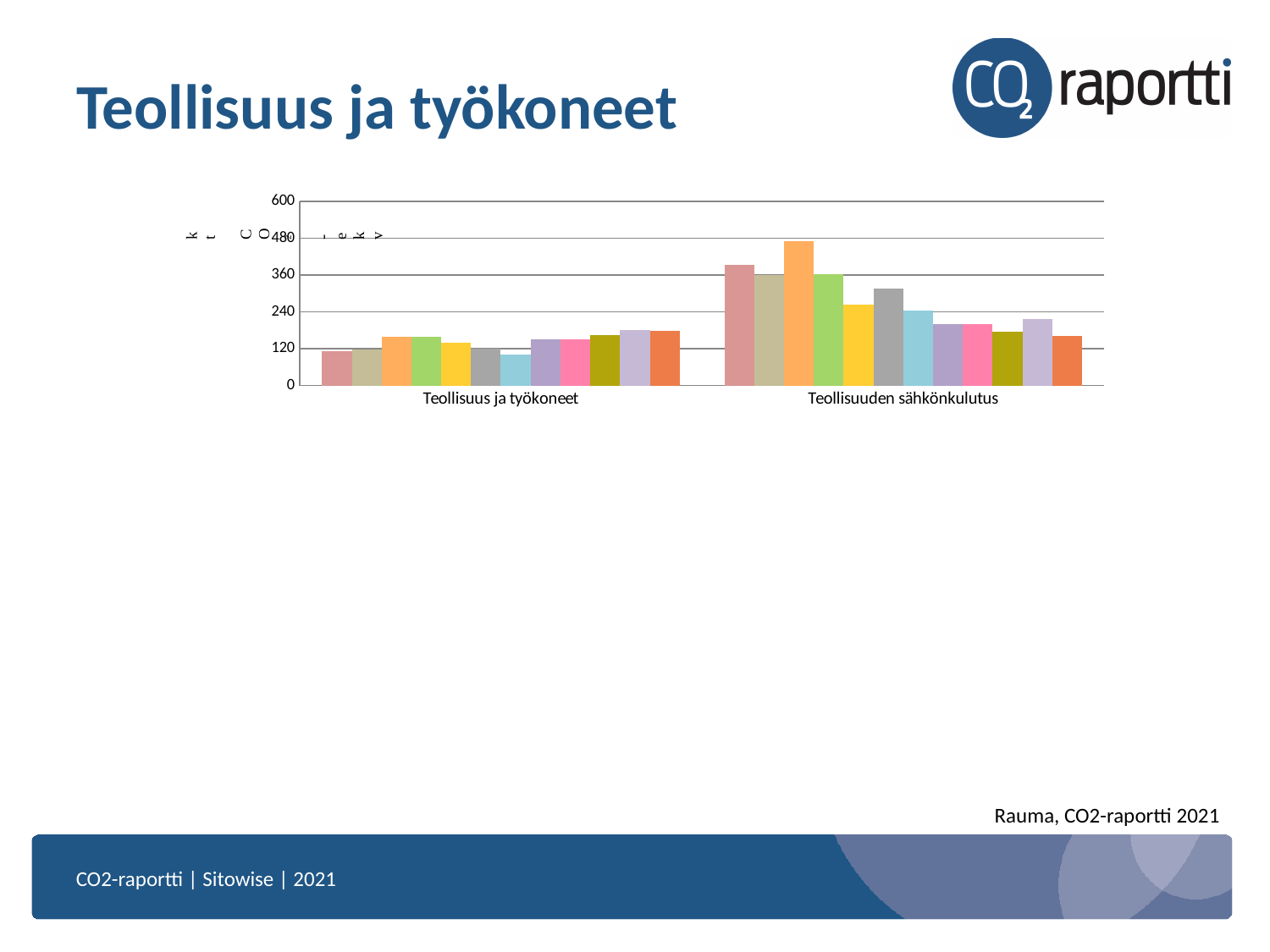
How many categories are shown on the x axis of the chart? 2 Is the tallest bar in the "Teollisuus ja työkoneet" group greater or less than 240? less What is the highest value shown on the y axis of the chart? 600 Which category has the lower bars overall, "Teollisuus ja työkoneet" or "Teollisuuden sähkönkulutus"? Teollisuus ja työkoneet Is the tallest bar in the "Teollisuuden sähkönkulutus" group greater or less than 600? less What are the two category labels on the x axis of the chart? Teollisuus ja työkoneet; Teollisuuden sähkönkulutus Is the tallest bar in the "Teollisuuden sähkönkulutus" group greater or less than 360? greater How many bars are plotted in the "Teollisuuden sähkönkulutus" group? 12 Which bar is the tallest within the "Teollisuuden sähkönkulutus" group, by its position from the left? the third bar What kind of chart is shown on the slide? bar chart Which category contains the tallest bar in the chart? Teollisuuden sähkönkulutus